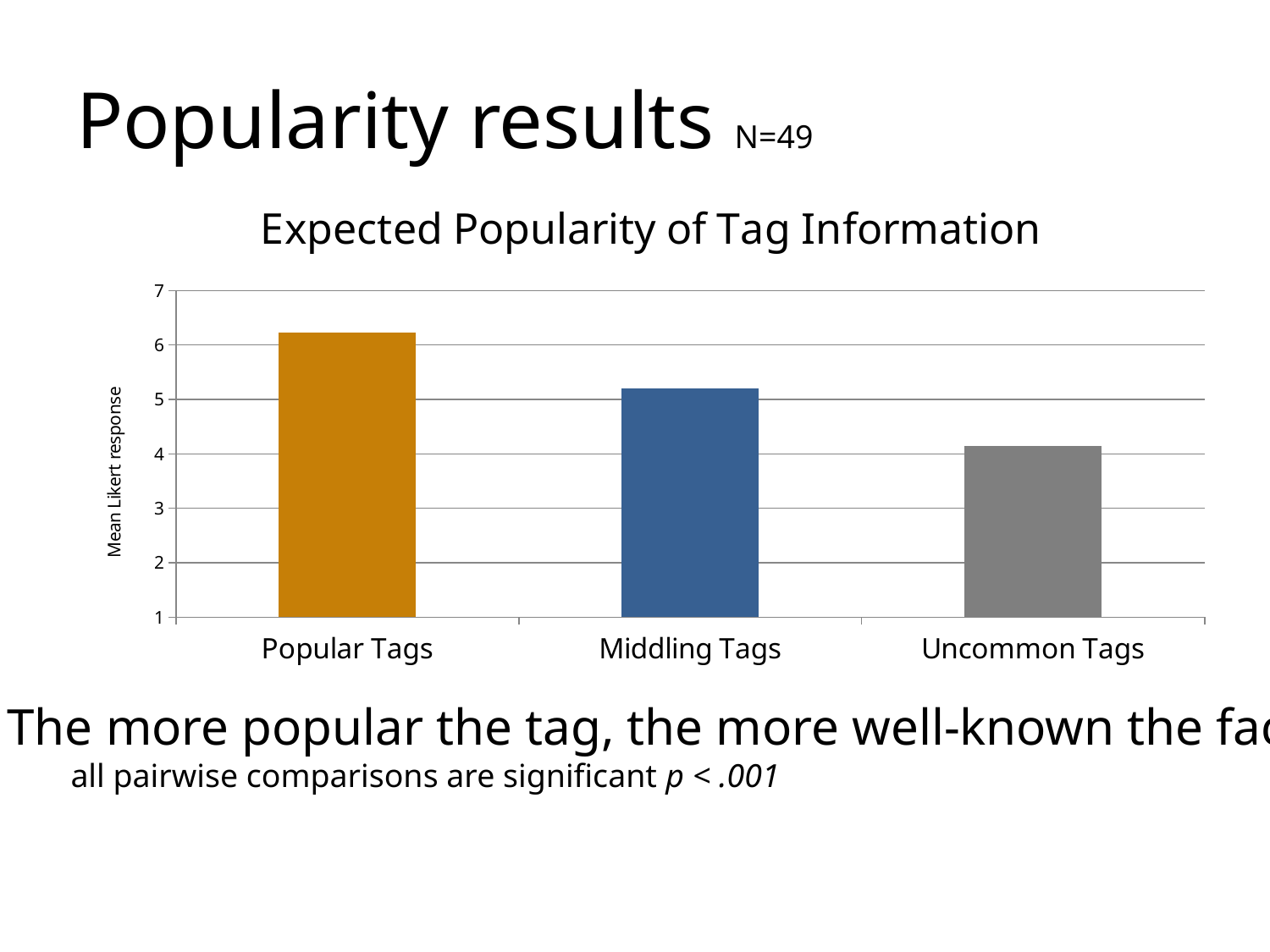
What is the label of the y axis? Mean Likert response How many categories are shown on the x axis of the chart? 3 Is the value for Popular Tags greater or less than 6? greater What is the title of the chart? Expected Popularity of Tag Information What type of chart is shown on the slide? bar chart Is the value for Uncommon Tags greater or less than 5? less Which is larger, the value for Popular Tags or the value for Middling Tags? Popular Tags Is the value for Middling Tags greater or less than 5? greater Which category has the highest mean Likert response? Popular Tags Which category has the lowest mean Likert response? Uncommon Tags Do the values rise or fall moving from Popular Tags to Uncommon Tags along the x axis? fall